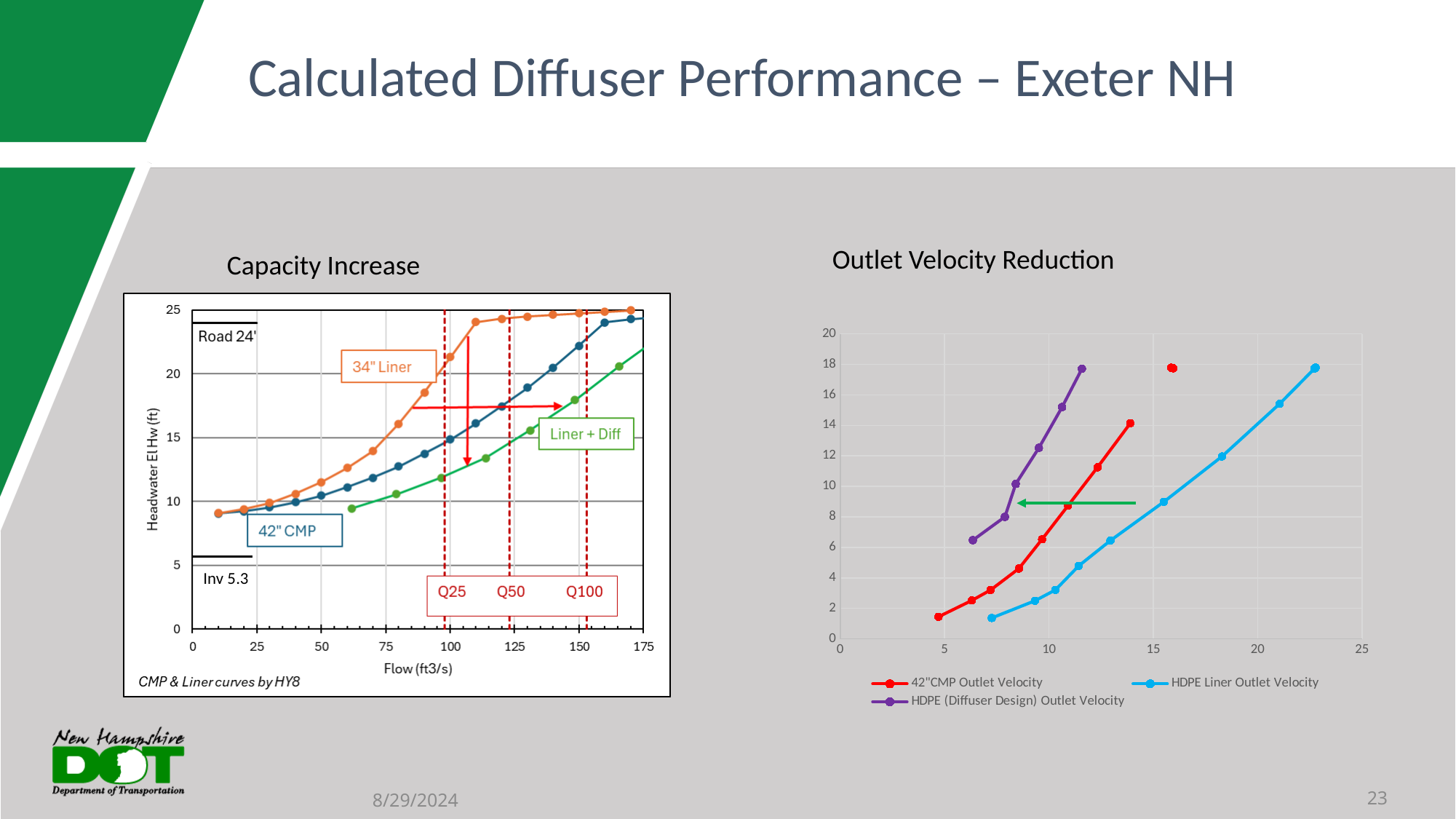
In the Capacity Increase chart, is the headwater elevation for Liner + Diff at a flow of 100 ft3/s greater or less than 15? less In the Capacity Increase chart, which series reaches the Road 24' elevation at the lowest flow? 34" Liner In the Outlet Velocity Reduction chart, is the highest point of the HDPE (Diffuser Design) Outlet Velocity series greater or less than 16? greater What is the x-axis label of the Capacity Increase chart? Flow (ft3/s) What colour is the HDPE Liner Outlet Velocity series in the Outlet Velocity Reduction chart? light blue In the Capacity Increase chart, at a flow of 100 ft3/s, which series has the higher headwater elevation: 34" Liner or Liner + Diff? 34" Liner In the Capacity Increase chart, does headwater elevation rise or fall as flow increases? rise How many series does the legend of the Outlet Velocity Reduction chart list? 3 In the Capacity Increase chart, is the headwater elevation for the 34" Liner at a flow of 100 ft3/s greater or less than 20? greater What type of chart is the Capacity Increase chart on the left? line chart